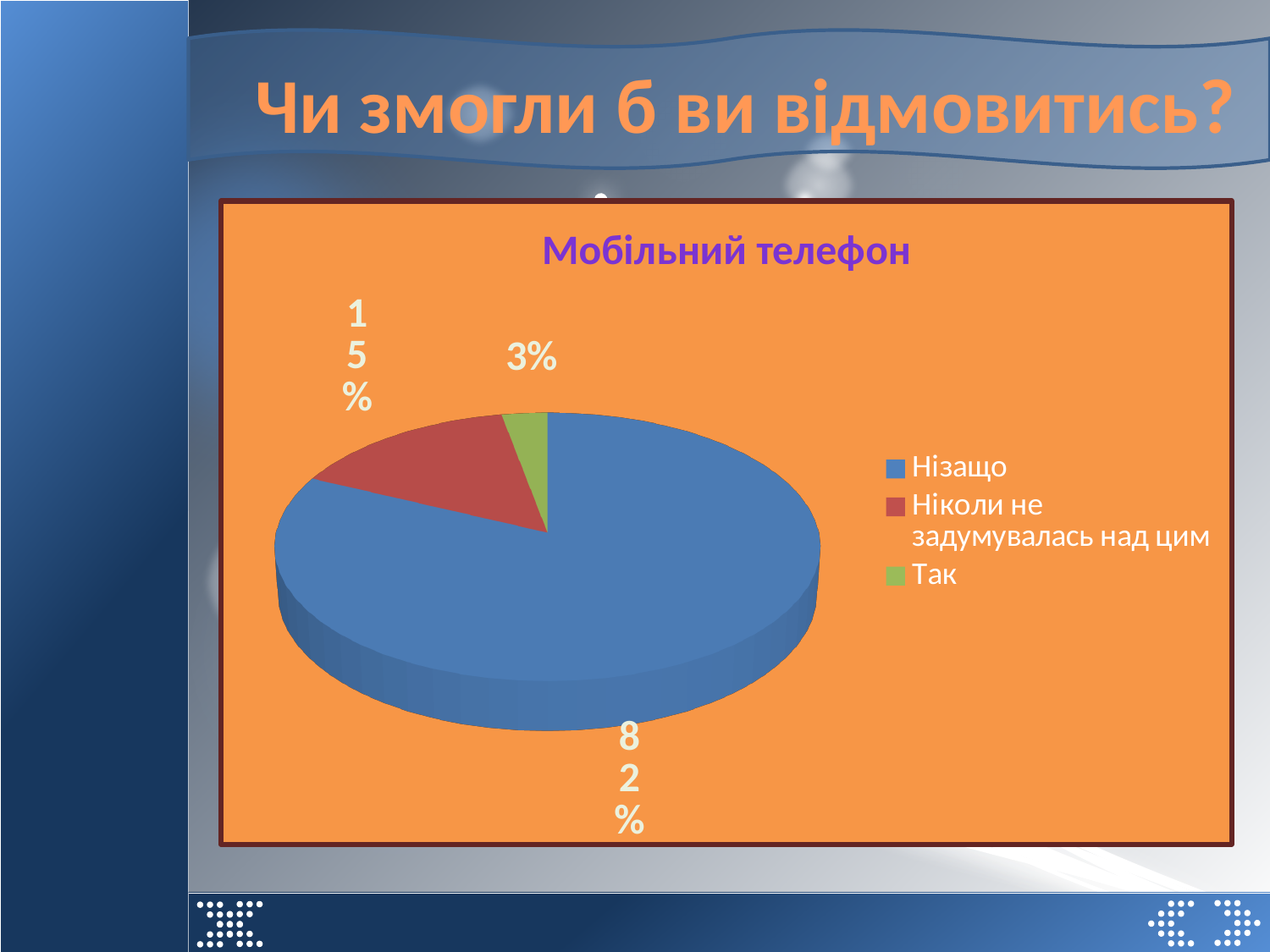
How many slices does the pie chart have? 3 Which category has the largest slice of the pie? Нізащо Which is larger, the slice for "Ніколи не задумувалась над цим" or the slice for "Так"? Ніколи не задумувалась над цим Which category has the smallest slice of the pie? Так What colour is the slice for "Так"? green What is the difference in percentage points between the "Нізащо" slice and the "Ніколи не задумувалась над цим" slice? 67 What kind of chart is shown on the slide? pie chart What share of the pie is labelled for "Ніколи не задумувалась над цим"? 15% How many entries does the legend list? 3 What share of the pie is labelled for "Нізащо"? 82% What share of the pie is labelled for "Так"? 3% What is the title of the chart? Мобільний телефон